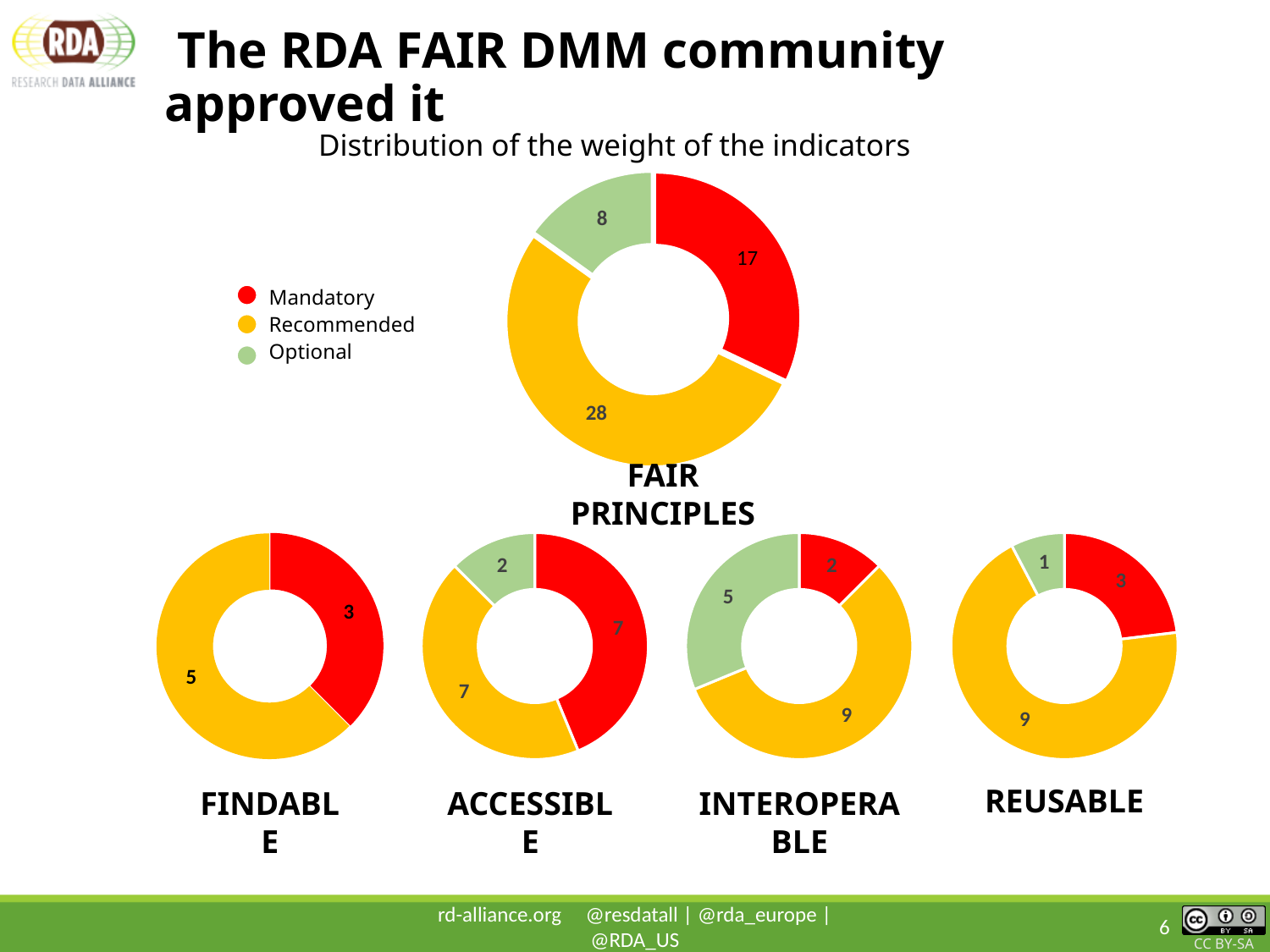
In the FINDABLE chart, what is the value for Recommended? 5 In the INTEROPERABLE chart, which category has the highest value? Recommended In the REUSABLE chart, what is the value for Optional? 1 In the ACCESSIBLE chart, what is the value for Optional? 2 In the FAIR PRINCIPLES chart, which category has the lowest value? Optional In the FAIR PRINCIPLES chart, what is the difference between the Recommended and Mandatory values? 11 What kind of chart is the FAIR PRINCIPLES chart? Doughnut chart In the FAIR PRINCIPLES chart, what is the value for Mandatory? 17 How many series does the legend list? 3 In the FAIR PRINCIPLES chart, what is the value for Recommended? 28 In the INTEROPERABLE chart, is the Optional value larger or the Mandatory value larger? Optional In the FINDABLE chart, what is the total of all the slices? 8